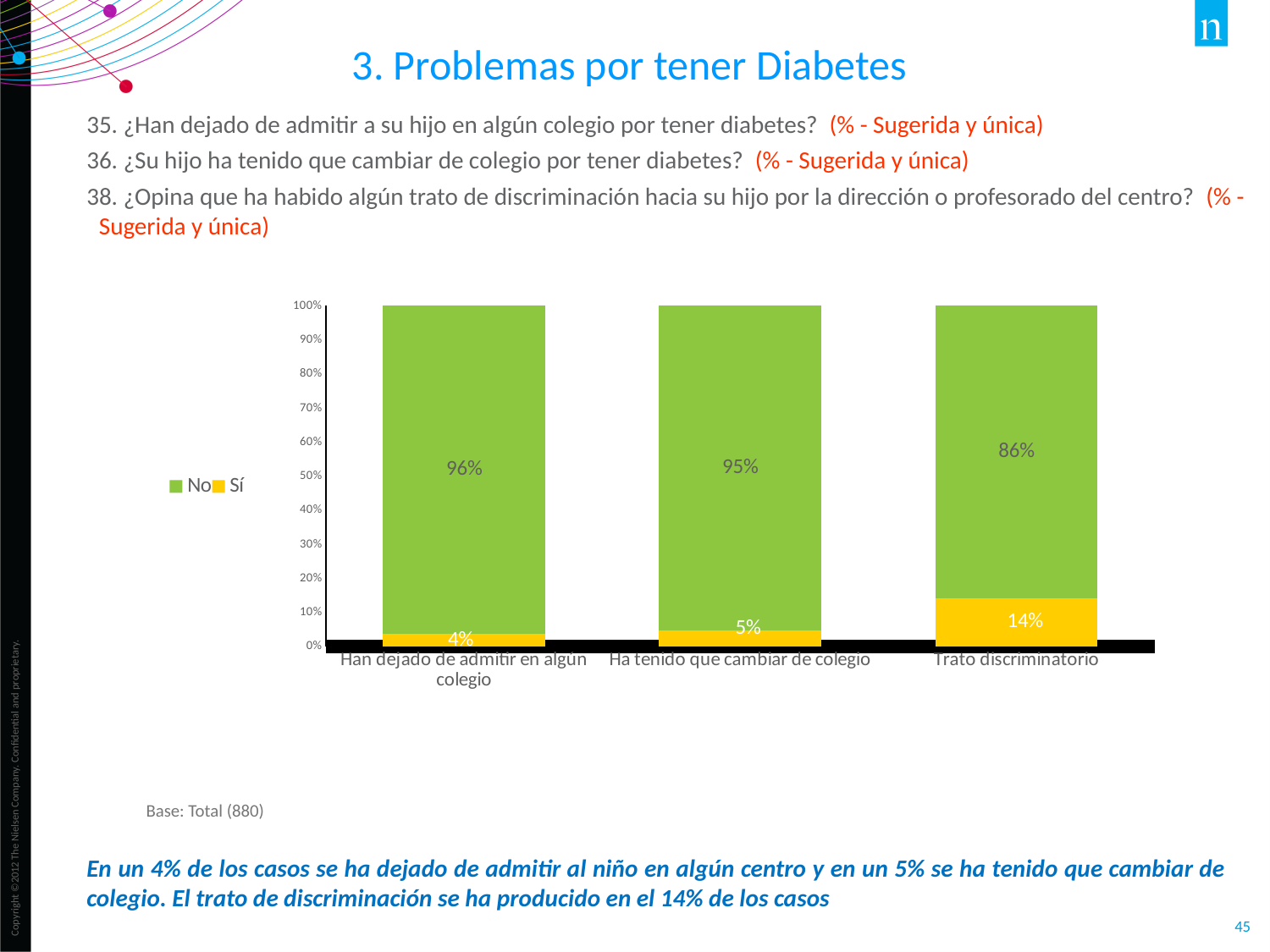
What kind of chart is shown on the slide? Stacked bar chart Which is larger: the 'No' value for 'Han dejado de admitir en algún colegio' or for 'Trato discriminatorio'? Han dejado de admitir en algún colegio Which colour represents the 'Sí' series in the legend? Yellow Is the 'Sí' value for 'Trato discriminatorio' greater or less than 10%? greater Which category has the highest 'Sí' value? Trato discriminatorio What is the 'Sí' value for 'Han dejado de admitir en algún colegio'? 4% What is the difference between the 'Sí' values for 'Trato discriminatorio' and 'Han dejado de admitir en algún colegio'? 10% How many series does the legend list? 2 What is the 'Sí' value for 'Ha tenido que cambiar de colegio'? 5% How many categories are shown on the x axis? 3 Which category has the lowest 'No' value? Trato discriminatorio What is the 'No' value for 'Trato discriminatorio'? 86%